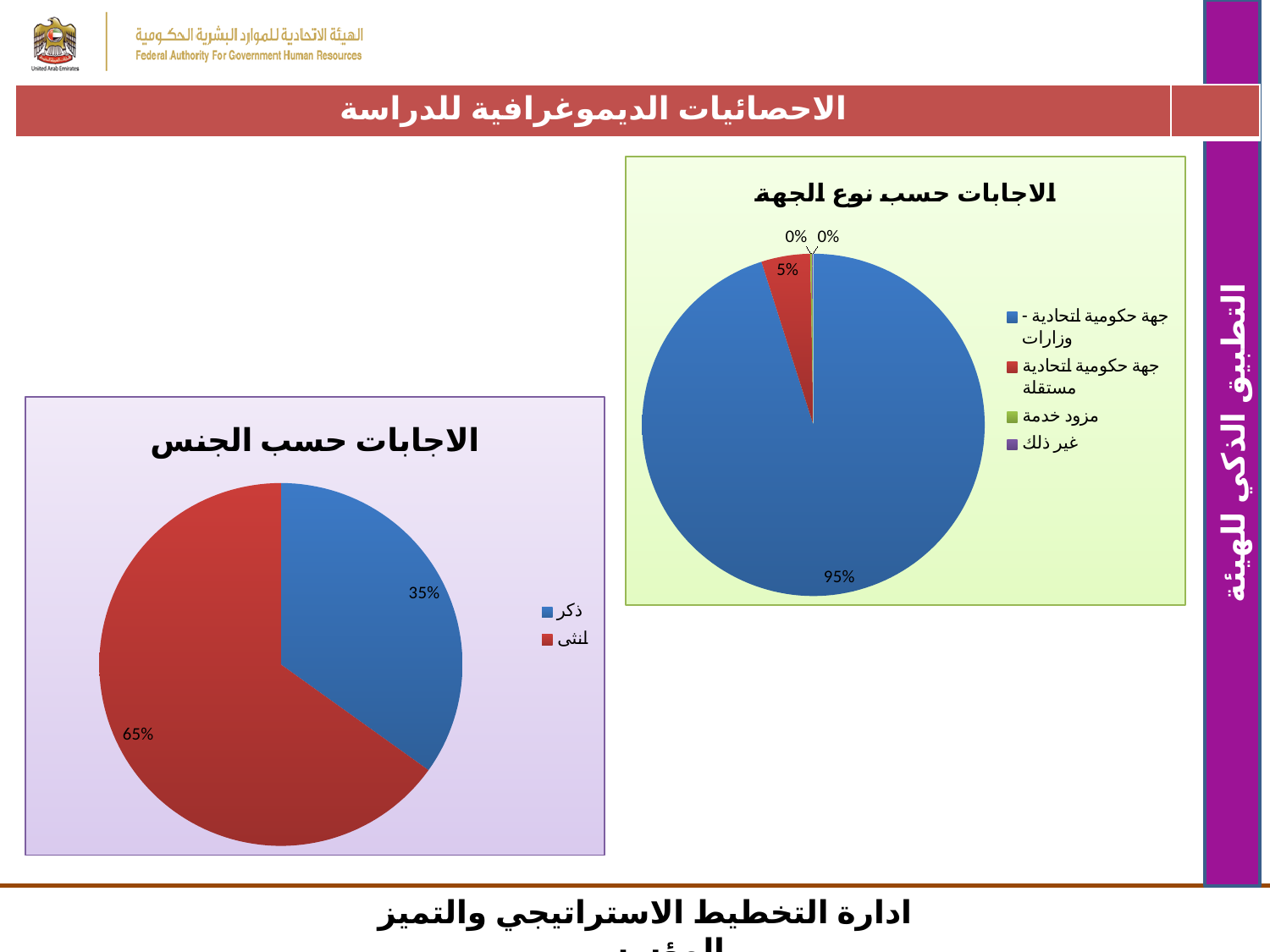
In the chart titled "الاجابات حسب نوع الجهة", what share is labelled for مزود خدمة? 0% In the chart titled "الاجابات حسب نوع الجهة", which category has the largest share? جهة حكومية اتحادية - وزارات In the chart titled "الاجابات حسب الجنس", how many entries does the legend list? 2 In the chart titled "الاجابات حسب نوع الجهة", what colour is the slice for جهة حكومية اتحادية مستقلة? red In the chart titled "الاجابات حسب نوع الجهة", what share is labelled for جهة حكومية اتحادية - وزارات? 95% In the chart titled "الاجابات حسب نوع الجهة", what share is labelled for جهة حكومية اتحادية مستقلة? 5% In the chart titled "الاجابات حسب الجنس", what share of responses is labelled for أنثى? 65% In the chart titled "الاجابات حسب الجنس", what share of responses is labelled for ذكر? 35% In the chart titled "الاجابات حسب نوع الجهة", how many categories does the legend list? 4 In the chart titled "الاجابات حسب الجنس", which category has the larger share? أنثى In the chart titled "الاجابات حسب الجنس", what is the difference in percentage points between أنثى and ذكر? 30 What kind of chart is the chart titled "الاجابات حسب الجنس"? pie chart